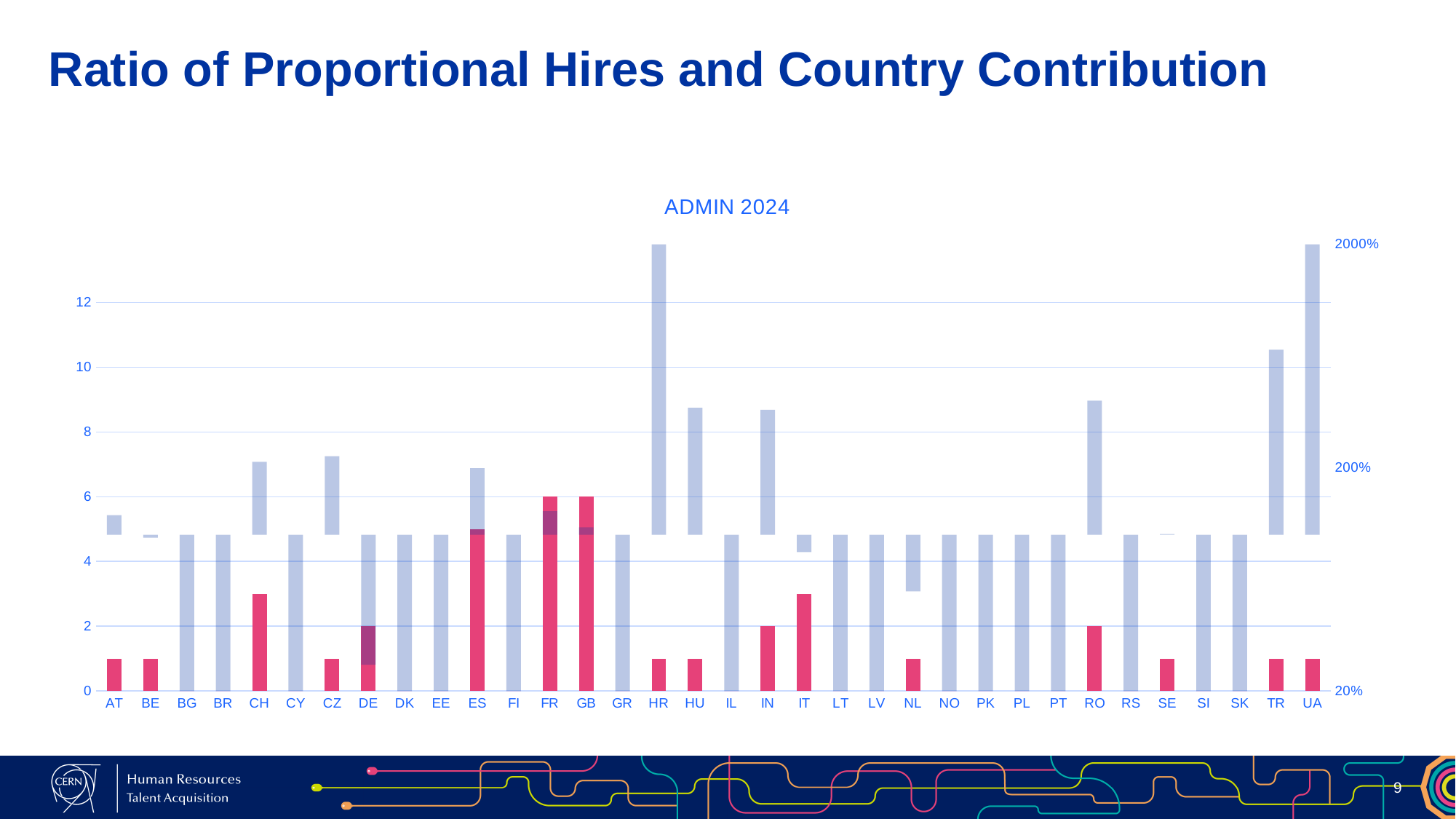
What kind of chart is shown on the slide? bar chart What is the title of the chart? ADMIN 2024 Is the light blue bar for BG greater or less than 200% on the right axis? less What is the value of the pink bar for FR on the left axis? 6 How many countries are listed along the x axis of the chart? 34 Is the light blue bar for HR greater or less than 200% on the right axis? greater What is the difference between the pink bar values for FR and IN? 4 What is the highest tick label shown on the right-hand axis? 2000% Which has the larger pink bar, GB or CH? GB